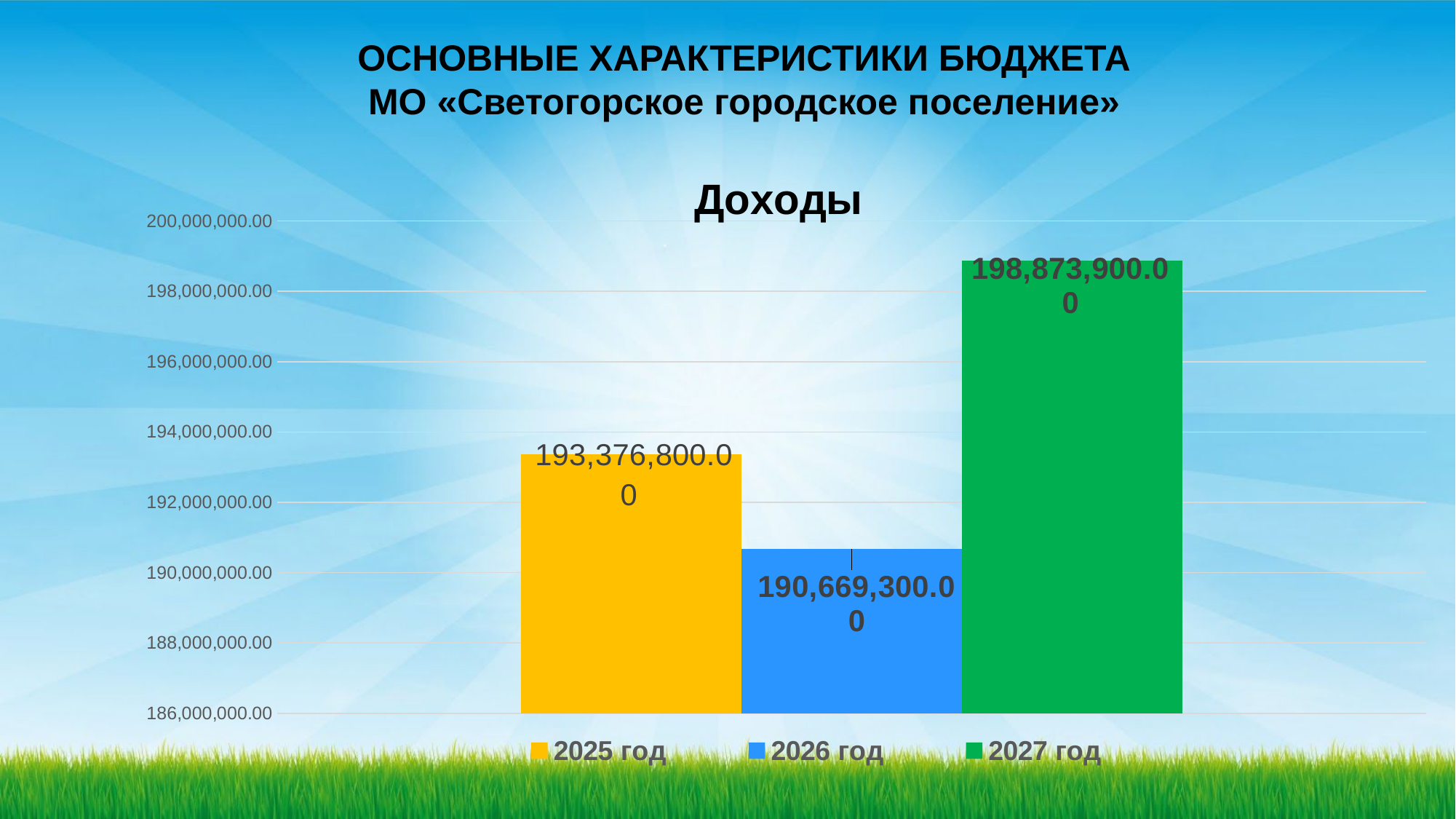
What colour is the bar for 2026 год in the Доходы chart? blue What is the difference between the values for 2025 год and 2026 год in the Доходы chart? 2,707,500.00 What is the value for 2027 год in the Доходы chart? 198,873,900.00 Is the value for 2027 год greater or less than 198,000,000.00? greater How many series does the legend list in the Доходы chart? 3 Which is larger in the Доходы chart, the value for 2025 год or 2026 год? 2025 год What is the difference between the values for 2027 год and 2025 год in the Доходы chart? 5,497,100.00 Which year has the lowest value in the Доходы chart? 2026 год What is the value for 2026 год in the Доходы chart? 190,669,300.00 What is the value for 2025 год in the Доходы chart? 193,376,800.00 What kind of chart is the Доходы chart? bar chart Which year has the highest value in the Доходы chart? 2027 год